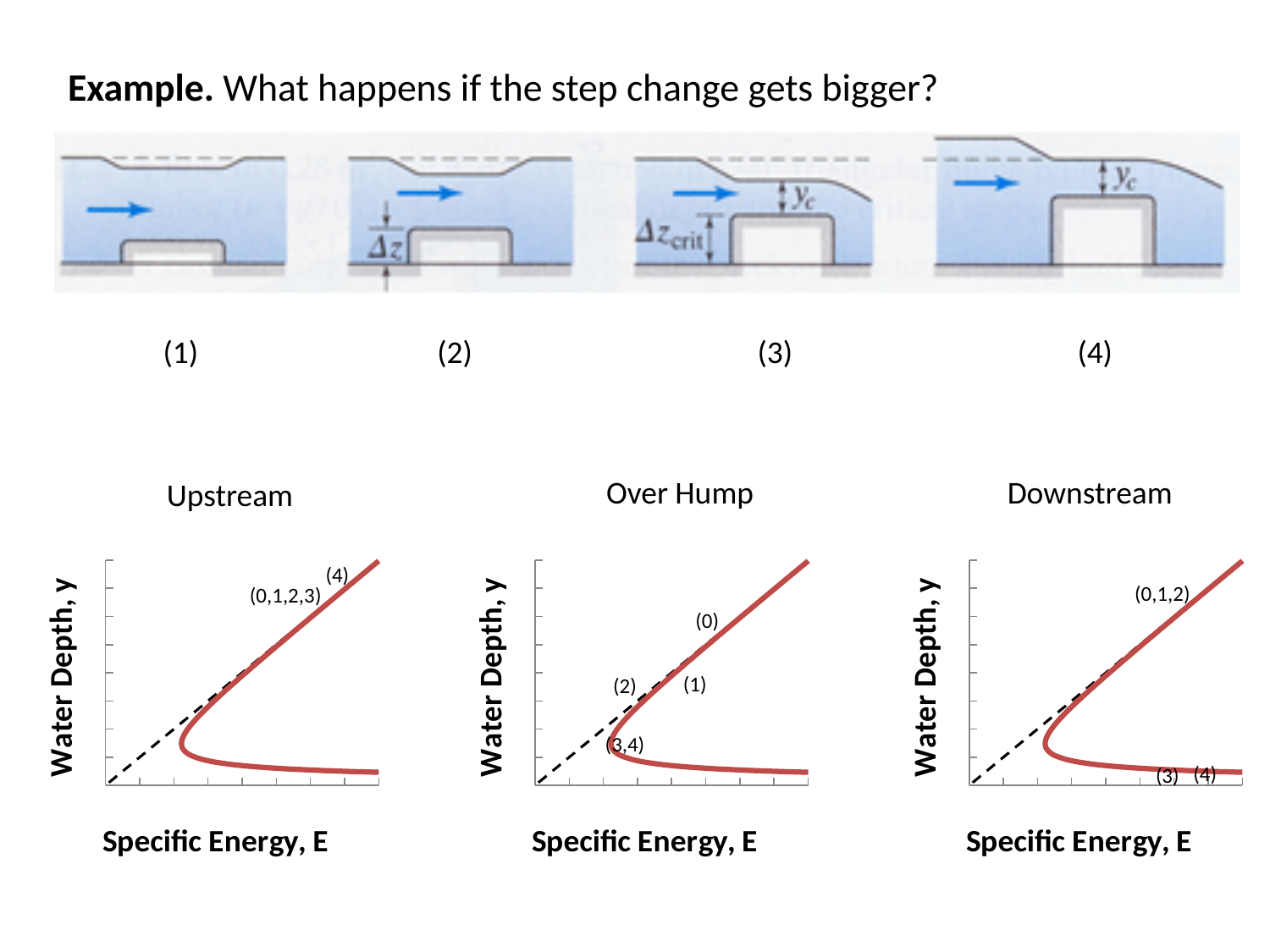
On the Over Hump chart, which label is placed at the nose of the curve? (3,4) What is the y-axis label of the Upstream chart? Water Depth, y What kind of chart is the Upstream chart? line chart What is the x-axis label of the Downstream chart? Specific Energy, E What kind of chart is the Over Hump chart? line chart On the Upstream chart, which label is placed highest on the curve? (4) On the Over Hump chart, how many labeled points are marked on the curve? 4 On the Downstream chart, which labels lie on the lower branch of the curve? (3) and (4) On the Downstream chart, how many labeled points are marked on the curve? 3 How many charts are shown on the slide? 3